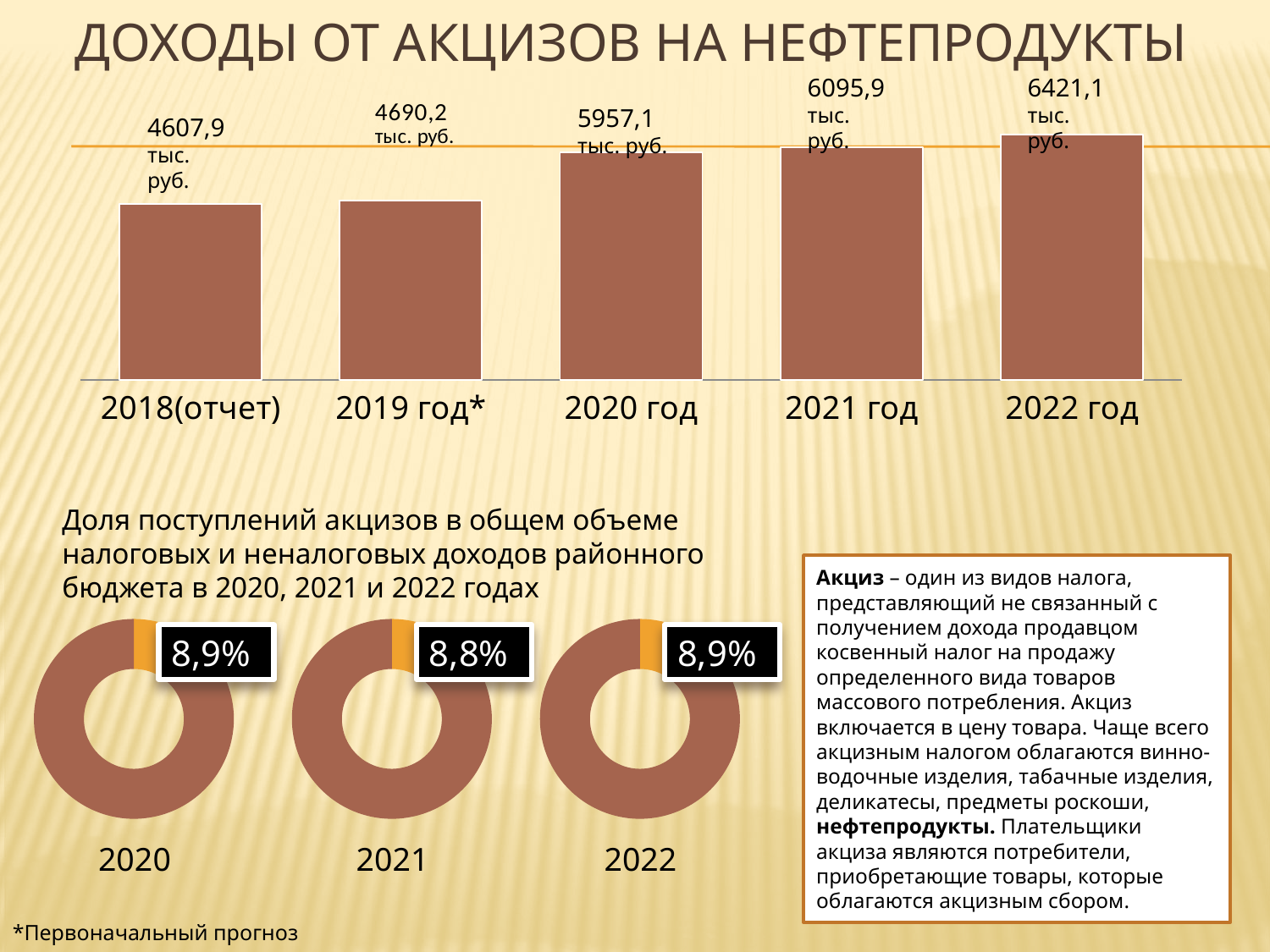
On the bar chart 'Доходы от акцизов на нефтепродукты', which category has the lowest value? 2018(отчет) On the bar chart 'Доходы от акцизов на нефтепродукты', what is the value for 2020 год? 5957,1 тыс. руб. How many donut charts are shown at the bottom of the slide? 3 On the donut charts at the bottom of the slide, what share is shown for 2021? 8,8% On the bar chart 'Доходы от акцизов на нефтепродукты', what is the value for 2018(отчет)? 4607,9 тыс. руб. On the bar chart 'Доходы от акцизов на нефтепродукты', do the values rise or fall from 2018 to 2022? Rise What kind of chart is the top chart 'Доходы от акцизов на нефтепродукты'? Bar chart On the bar chart 'Доходы от акцизов на нефтепродукты', which year has the highest value? 2022 год How many bars are on the bar chart 'Доходы от акцизов на нефтепродукты'? 5 On the bar chart 'Доходы от акцизов на нефтепродукты', which is larger: the value for 2019 год* or the value for 2020 год? 2020 год On the bar chart 'Доходы от акцизов на нефтепродукты', what is the difference between the values for 2022 год and 2018(отчет)? 1813,2 тыс. руб. On the bar chart 'Доходы от акцизов на нефтепродукты', what is the difference between the values for 2021 год and 2020 год? 138,8 тыс. руб.